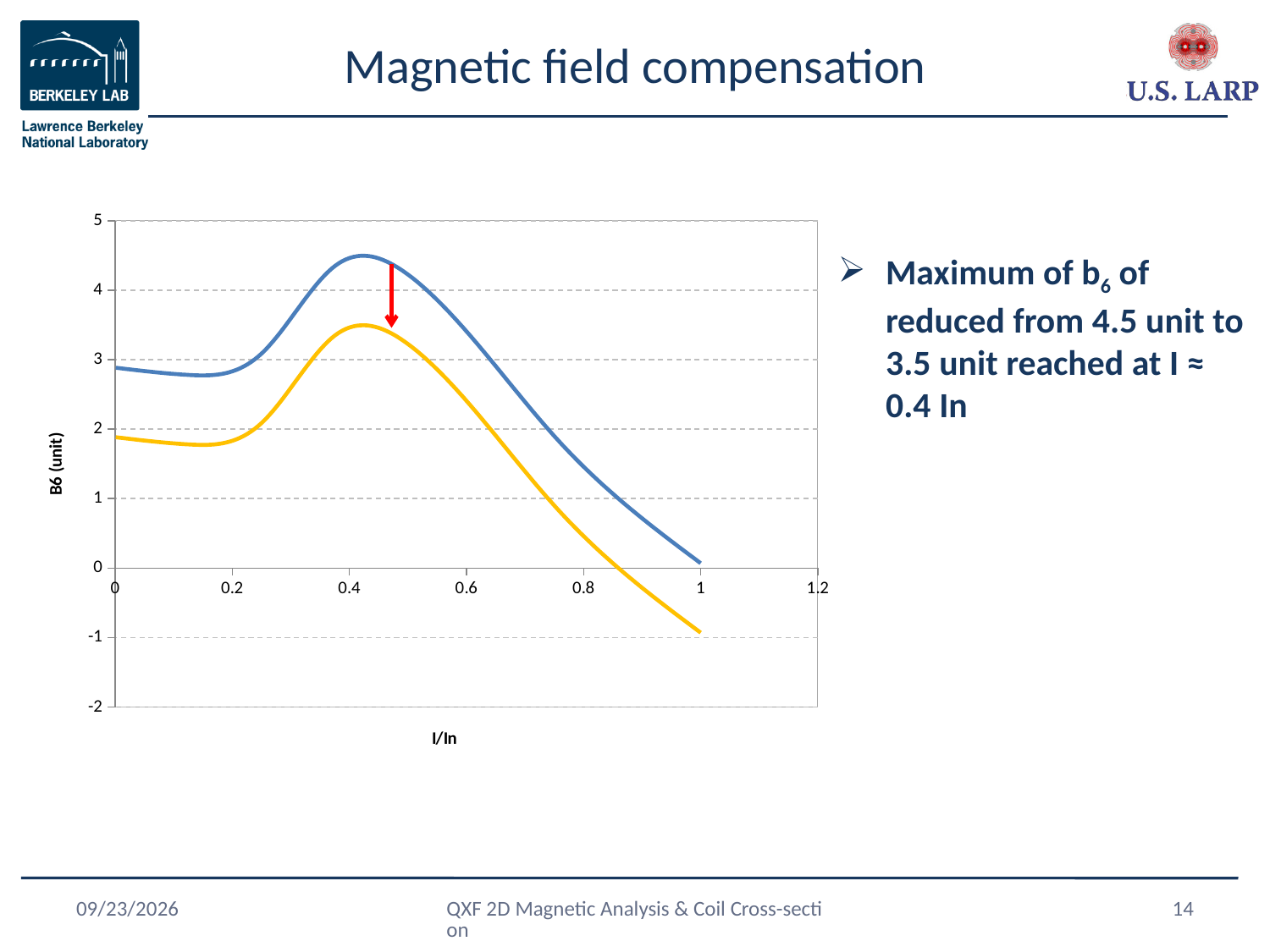
Is the value of the yellow line at I/In = 0.4 greater or less than 3? greater At I/In = 0.4, which line has the higher value, the blue line or the yellow line? blue line What kind of chart is shown on the slide? line chart Between I/In = 0.2 and I/In = 0.4, does the yellow line rise or fall? rise Is the value of the yellow line at I/In = 0.6 greater or less than 3? less What is the label of the vertical axis of the chart? B6 (unit) Between I/In = 0.4 and I/In = 1, does the blue line rise or fall? fall How many lines are plotted on the chart? 2 Is the value of the yellow line at I/In = 1 greater or less than 0? less Which line reaches the higher peak, the blue line or the yellow line? blue line